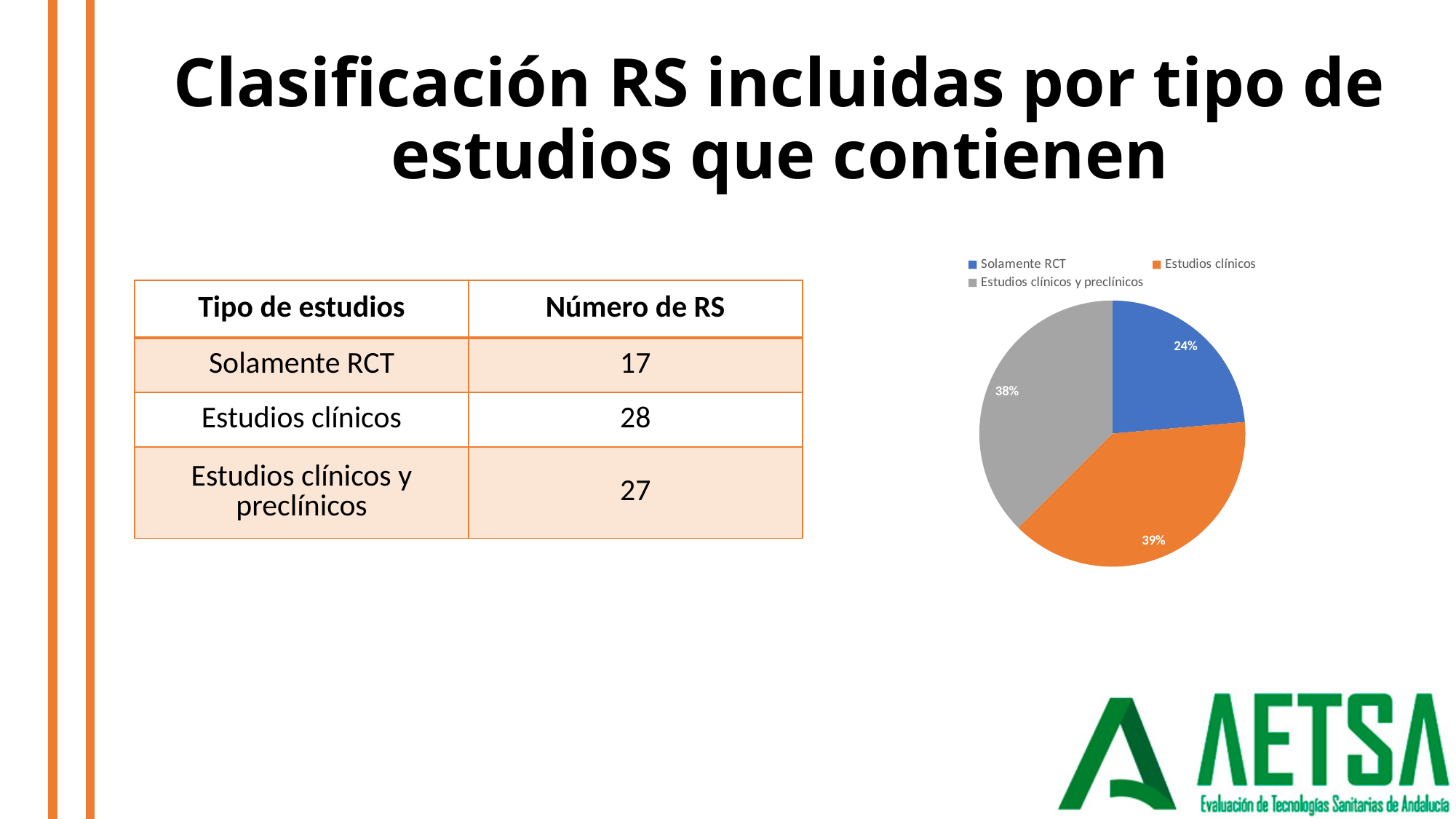
Which slice is larger in the pie chart, Solamente RCT or Estudios clínicos y preclínicos? Estudios clínicos y preclínicos What is the difference in percentage points between the Estudios clínicos slice and the Solamente RCT slice? 15 How many entries does the pie chart legend list? 3 Which category has the largest slice in the pie chart? Estudios clínicos What share of the pie chart does Estudios clínicos y preclínicos represent? 38% What kind of chart is shown on the slide? pie chart Which category has the smallest slice in the pie chart? Solamente RCT What share of the pie chart does Estudios clínicos represent? 39% What colour is the Solamente RCT slice in the pie chart? blue How many slices does the pie chart have? 3 What share of the pie chart does Solamente RCT represent? 24% Which category is shown in grey in the pie chart? Estudios clínicos y preclínicos